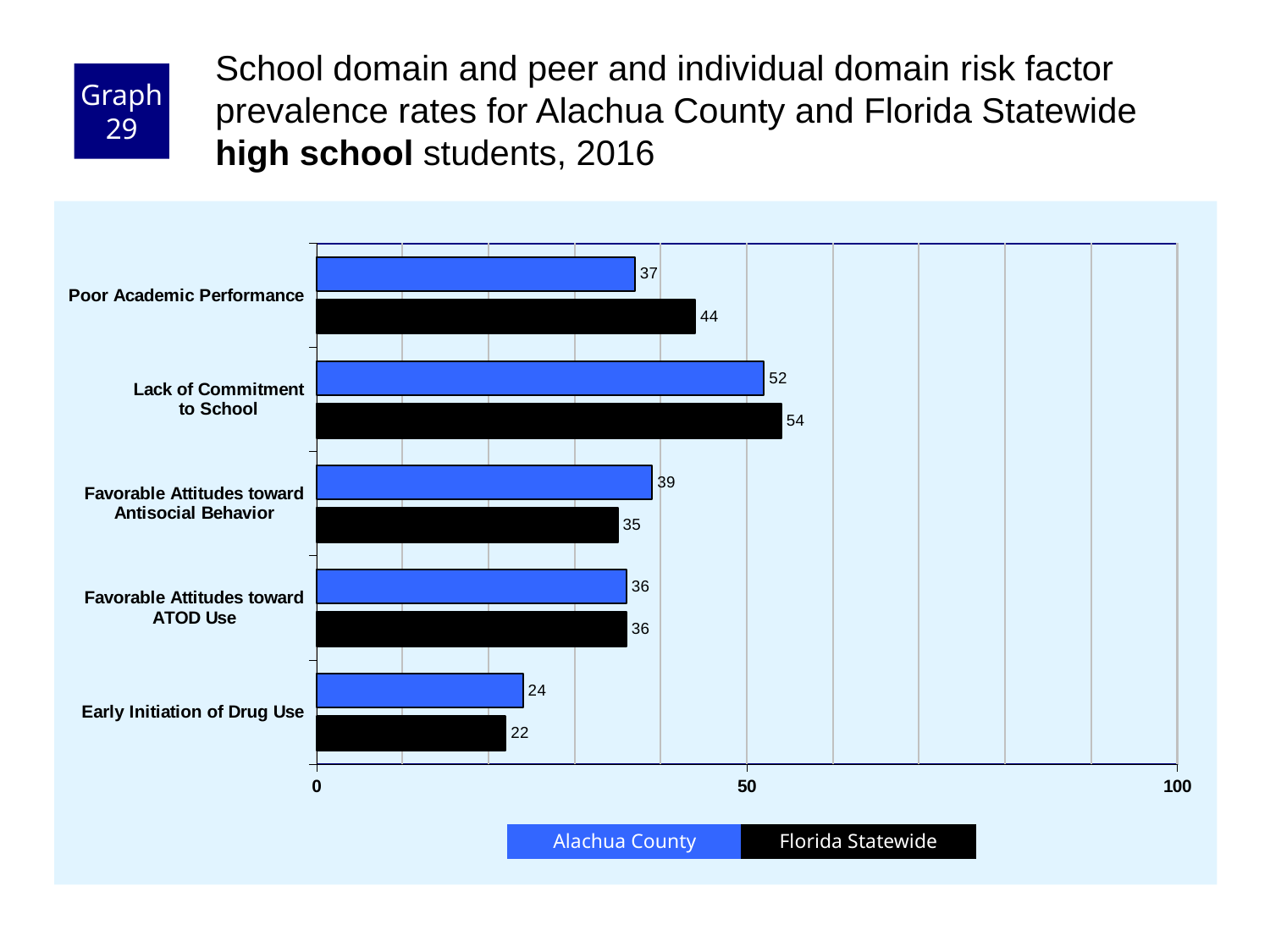
What is the Florida Statewide value for Lack of Commitment to School? 54 What is the difference between the Florida Statewide and Alachua County values for Poor Academic Performance? 7 What is the Alachua County value for Poor Academic Performance? 37 Is the Alachua County value for Lack of Commitment to School greater or less than 50? greater How many series does the legend list? 2 What is the Florida Statewide value for Early Initiation of Drug Use? 22 For Favorable Attitudes toward Antisocial Behavior, which is larger: the Alachua County value or the Florida Statewide value? Alachua County Which risk factor has the highest Alachua County value? Lack of Commitment to School Which colour represents Florida Statewide in the chart? Black Which risk factor has the lowest Florida Statewide value? Early Initiation of Drug Use How many risk factor categories are shown on the chart? 5 What kind of chart is shown on the slide? Bar chart